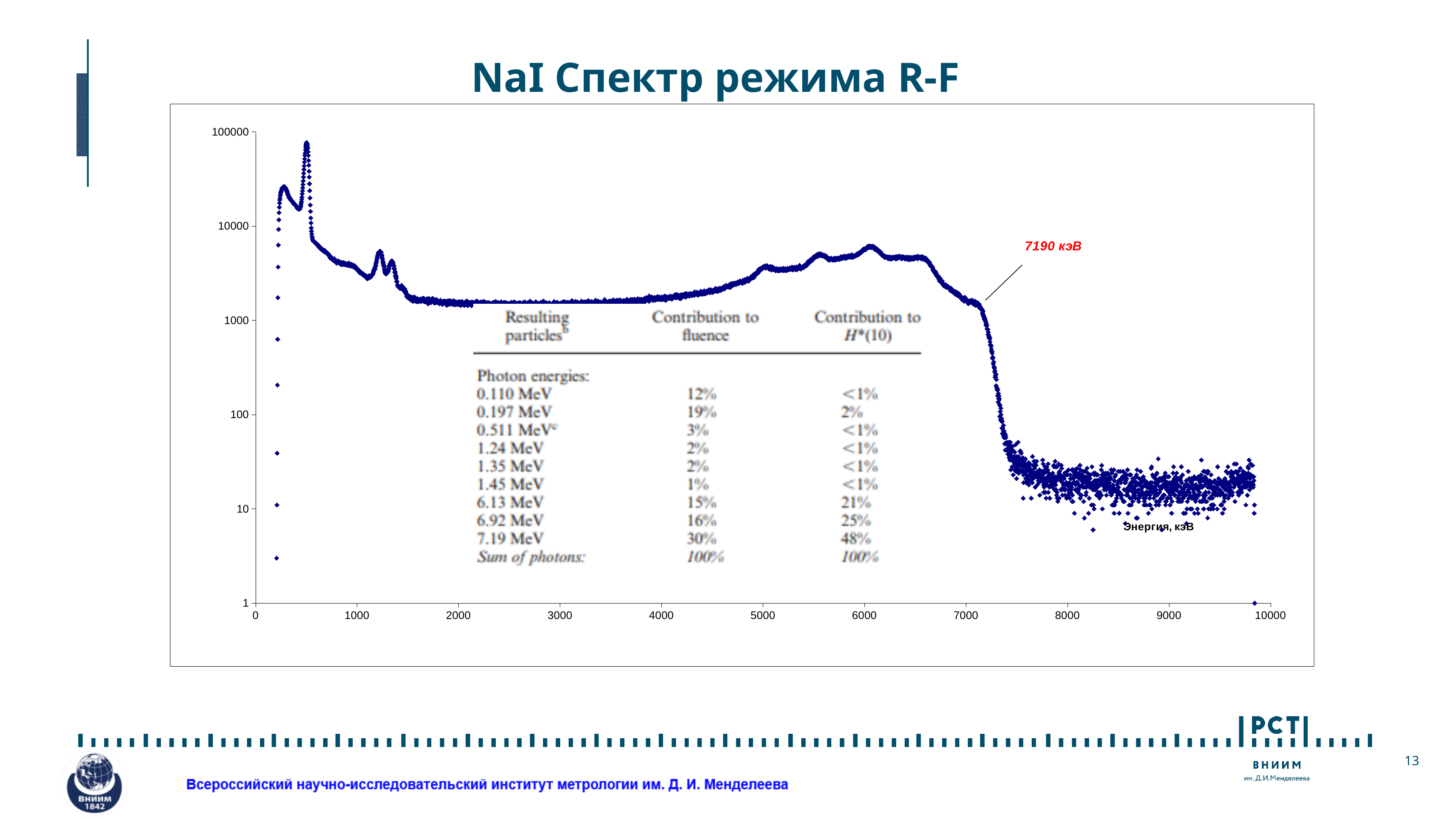
Do the spectrum values rise or fall as energy increases from 7000 to 8000 кэВ? fall What is the title of the chart on the slide? NaI Спектр режима R-F What kind of chart is shown on the slide? scatter chart Between which two x-axis ticks does the highest peak of the spectrum lie? 0 and 1000 What is the highest value shown on the x axis of the chart? 10000 What energy value is marked by the red annotation on the chart? 7190 кэВ Is the value of the spectrum at an energy of 3000 кэВ greater or less than 1000? greater Is the value of the spectrum at an energy of 9000 кэВ greater or less than 100? less Which is larger: the spectrum value at 6000 кэВ or at 9000 кэВ? 6000 кэВ Is the value at the highest peak of the spectrum greater or less than 10000? greater Which is larger: the peak near 500 кэВ or the peak near 6000 кэВ? the peak near 500 кэВ Do the spectrum values rise or fall as energy increases from 4000 to 6000 кэВ? rise